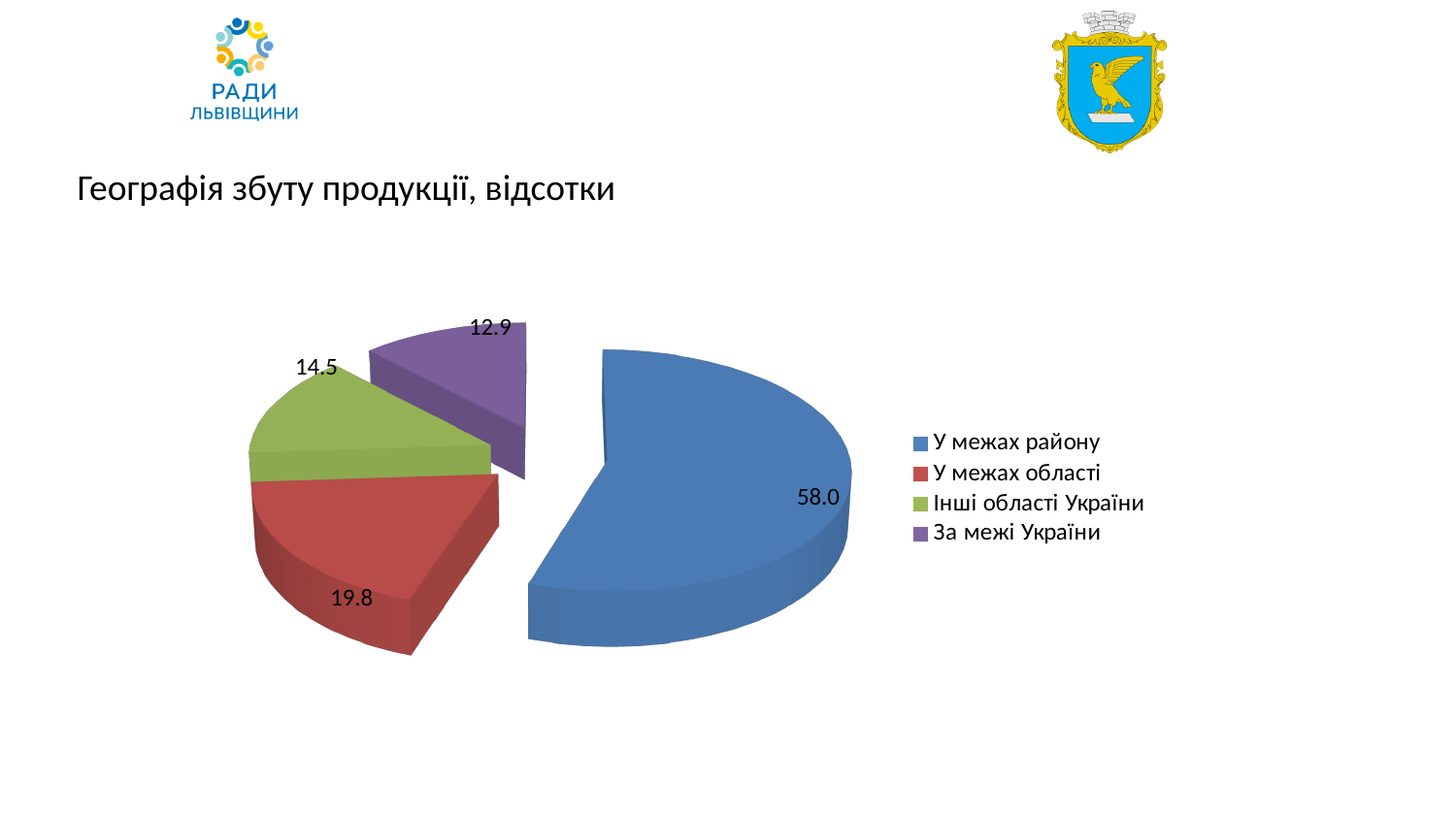
How many slices does the pie chart have? 4 What is the difference between the values for 'У межах району' and 'У межах області'? 38.2 What value is shown for the slice 'У межах області'? 19.8 What value is shown for the slice 'За межі України'? 12.9 Which is larger, the value for 'У межах області' or the value for 'Інші області України'? У межах області What is the title of the chart on the slide? Географія збуту продукції, відсотки Which category has the smallest slice of the pie? За межі України What is the difference between the values for 'Інші області України' and 'За межі України'? 1.6 What value is shown for the slice 'У межах району'? 58.0 What kind of chart is shown on the slide? Pie chart Which category has the largest slice of the pie? У межах району What value is shown for the slice 'Інші області України'? 14.5